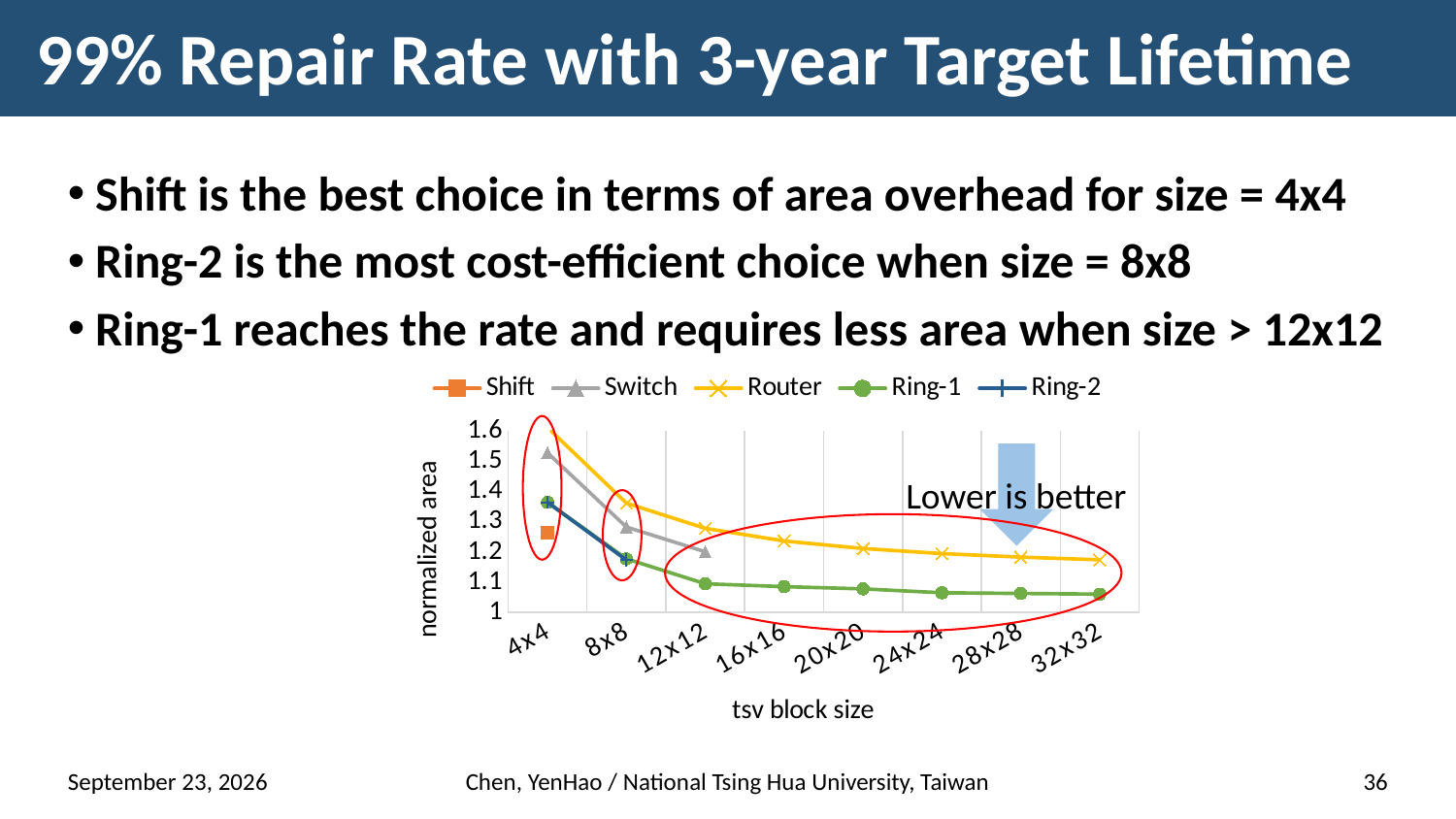
Which series has the lowest normalized area at 4x4? Shift What is the label of the x axis? tsv block size Is the value for Router at 4x4 greater or less than 1.5? greater How many series does the legend list? 5 How many tsv block size categories are shown on the x axis? 8 Is the value for Ring-1 at 32x32 greater or less than 1.1? less At 16x16, which is larger: Router or Ring-1? Router What is the label of the y axis? normalized area Is the value for Switch at 4x4 greater or less than 1.4? greater Which series has the highest normalized area at 4x4? Router Does the Router series rise or fall as tsv block size increases? fall What kind of chart is shown on the slide? line chart